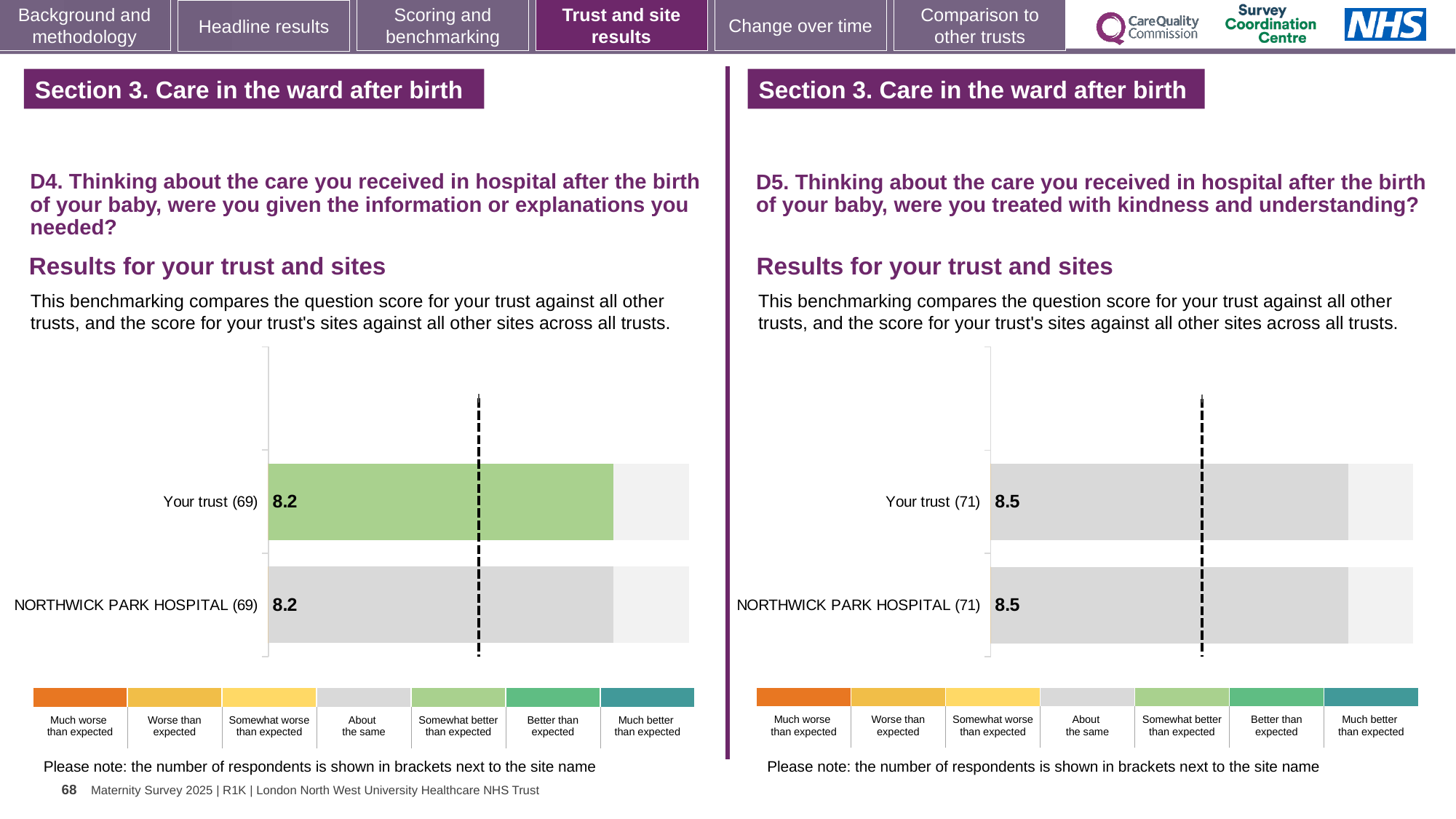
How many bars are plotted in the D5 chart on the right? 2 In the D5 chart on the right, how many respondents are shown in brackets next to NORTHWICK PARK HOSPITAL? 71 In the D4 chart on the left, what is the score for NORTHWICK PARK HOSPITAL? 8.2 In the D4 chart on the left, which benchmark category does the green colour of the Your trust bar correspond to in the key? Somewhat better than expected In the D5 chart on the right, what is the difference between the score for Your trust and the score for NORTHWICK PARK HOSPITAL? 0 In the D4 chart on the left, how many respondents are shown in brackets next to Your trust? 69 How many bars are plotted in the D4 chart on the left? 2 In the D4 chart on the left, what is the difference between the score for Your trust and the score for NORTHWICK PARK HOSPITAL? 0 What kind of chart is used for the D4 results on the left? Bar chart In the D4 chart on the left, what is the score for Your trust? 8.2 In the D5 chart on the right, what is the score for Your trust? 8.5 In the D5 chart on the right, what is the score for NORTHWICK PARK HOSPITAL? 8.5